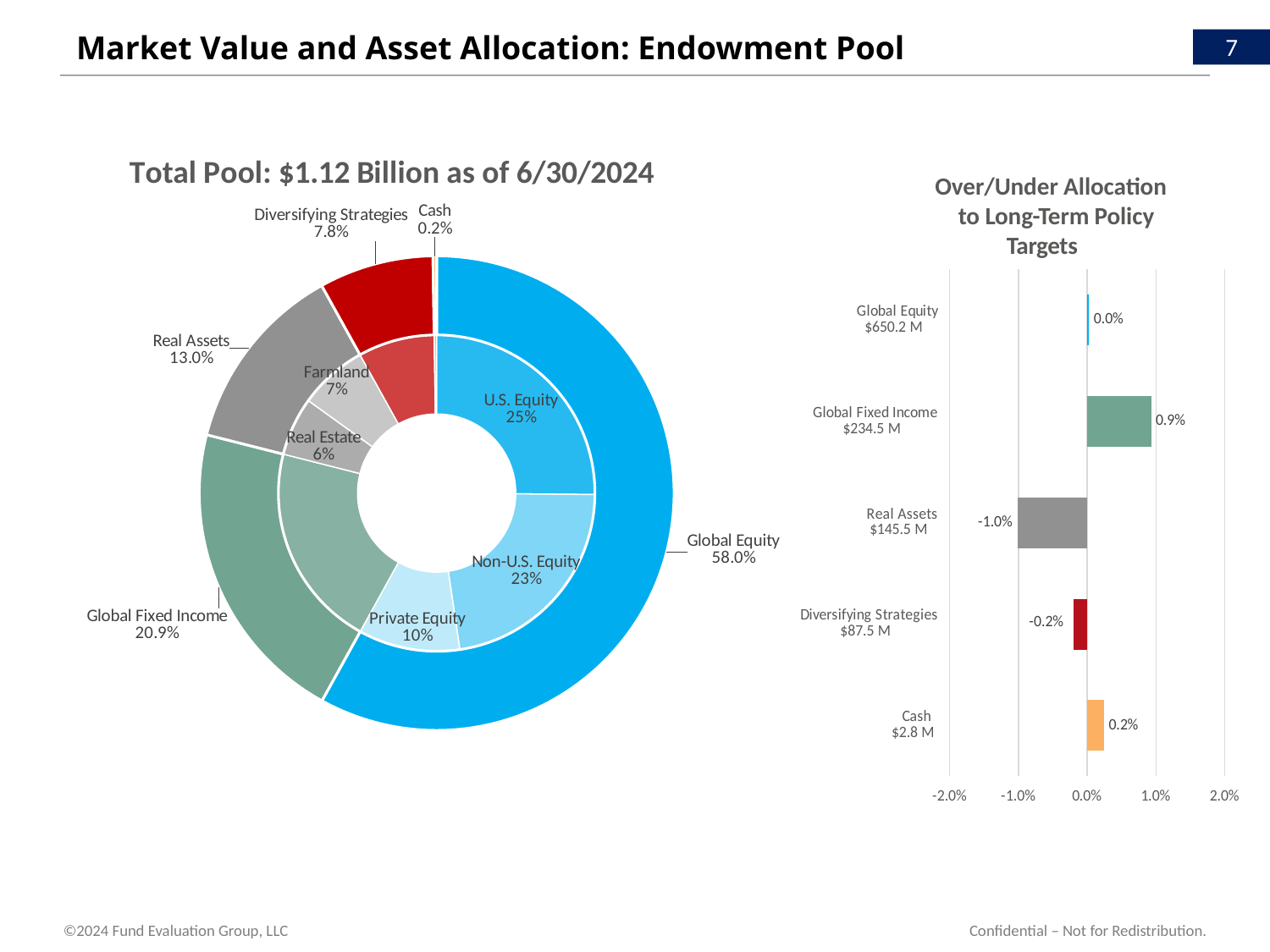
In the 'Over/Under Allocation to Long-Term Policy Targets' chart, which category has the lowest value? Real Assets In the 'Over/Under Allocation to Long-Term Policy Targets' chart, how many categories are shown? 5 In the 'Over/Under Allocation to Long-Term Policy Targets' chart, what market value is shown for Diversifying Strategies? $87.5 M In the 'Total Pool: $1.12 Billion as of 6/30/2024' chart, what share is Private Equity? 10% In the 'Total Pool: $1.12 Billion as of 6/30/2024' chart, which outer-ring category has the smallest share? Cash In the 'Total Pool: $1.12 Billion as of 6/30/2024' chart, what share of the pool is Global Fixed Income? 20.9% In the 'Over/Under Allocation to Long-Term Policy Targets' chart, what is the value for Global Fixed Income? 0.9% What kind of chart is the 'Over/Under Allocation to Long-Term Policy Targets' chart? Bar chart What kind of chart is the 'Total Pool: $1.12 Billion as of 6/30/2024' chart? Donut chart In the 'Total Pool: $1.12 Billion as of 6/30/2024' chart, what share of the pool is Global Equity? 58.0% In the 'Total Pool: $1.12 Billion as of 6/30/2024' chart, what is the difference between the Real Assets share and the Diversifying Strategies share? 5.2% In the 'Total Pool: $1.12 Billion as of 6/30/2024' chart, which is larger, U.S. Equity or Non-U.S. Equity? U.S. Equity